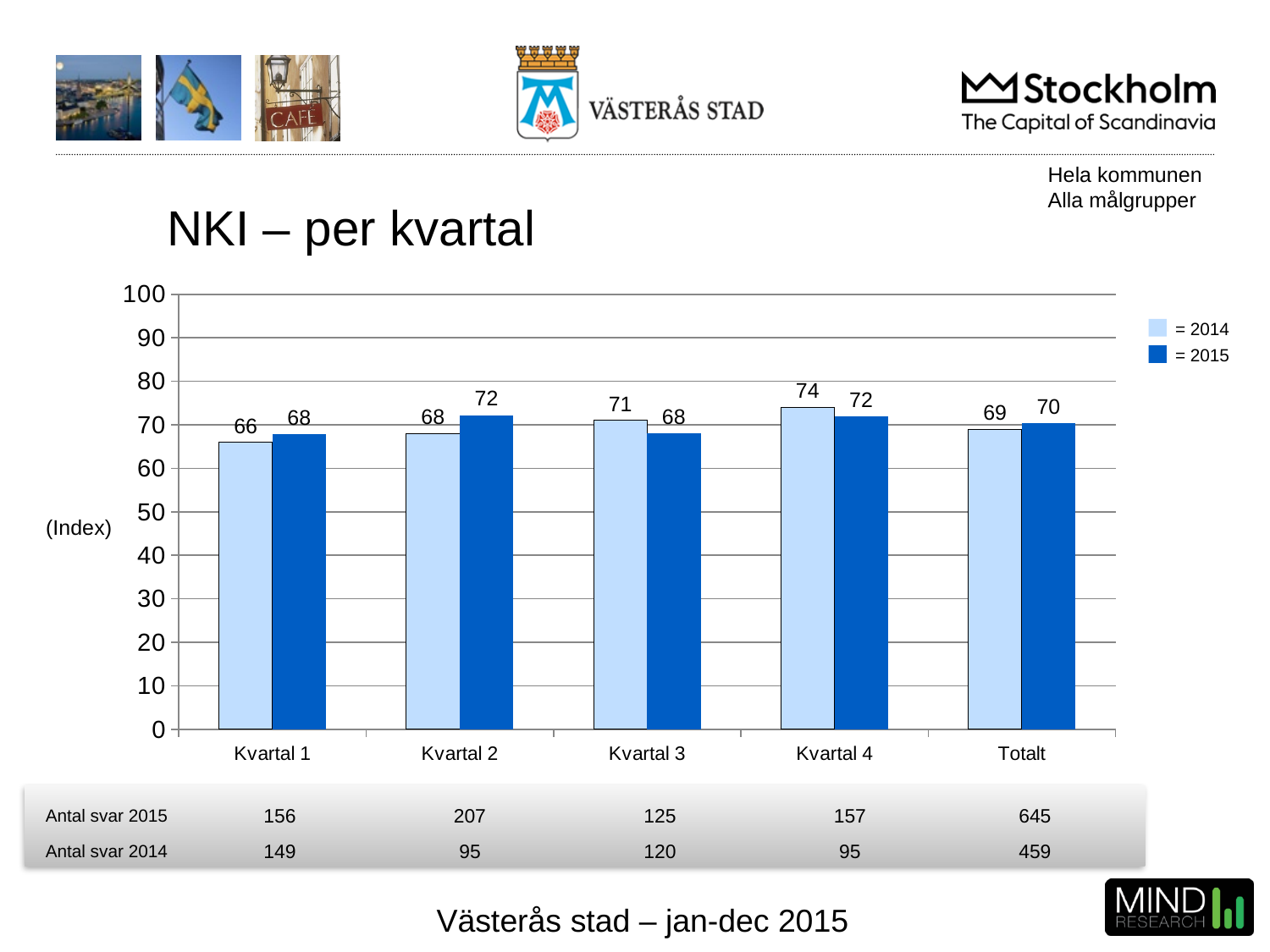
What is the 2015 value for Kvartal 2? 72 What is the 2014 value for Kvartal 4? 74 What is the 2015 value for Totalt? 70 How many series does the legend list? 2 How many categories are shown on the x axis? 5 What is the difference between the 2015 and 2014 values for Kvartal 2? 4 Which category has the highest 2014 value? Kvartal 4 Which category has the lowest 2014 value? Kvartal 1 What kind of chart is shown? bar chart What is the title of the chart? NKI – per kvartal Is the 2015 value for Kvartal 1 greater or less than 60? greater For Kvartal 3, which is larger, the 2014 value or the 2015 value? 2014